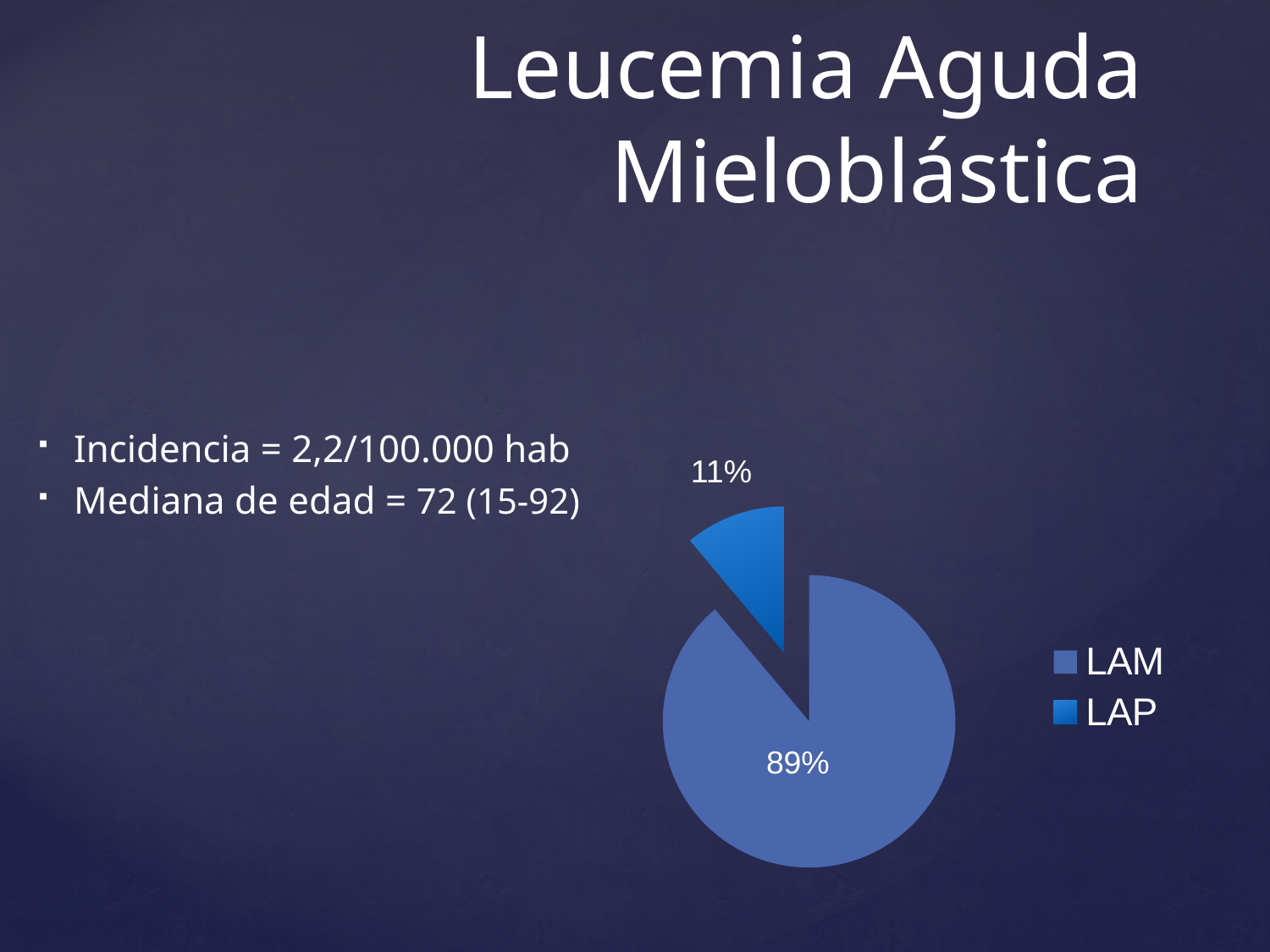
Which slice of the pie is the smallest? LAP Which legend entry is shown in the darker blue colour? LAP What share of the pie does LAP represent? 11% Which is larger, the LAM slice or the LAP slice? LAM Which slice of the pie is the largest? LAM How many slices does the pie chart have? 2 Which slice is pulled out (exploded) from the pie? LAP What is the difference in percentage points between the LAM and LAP slices? 78 How many entries does the legend list? 2 What kind of chart is shown on the slide? Pie chart What share of the pie does LAM represent? 89%